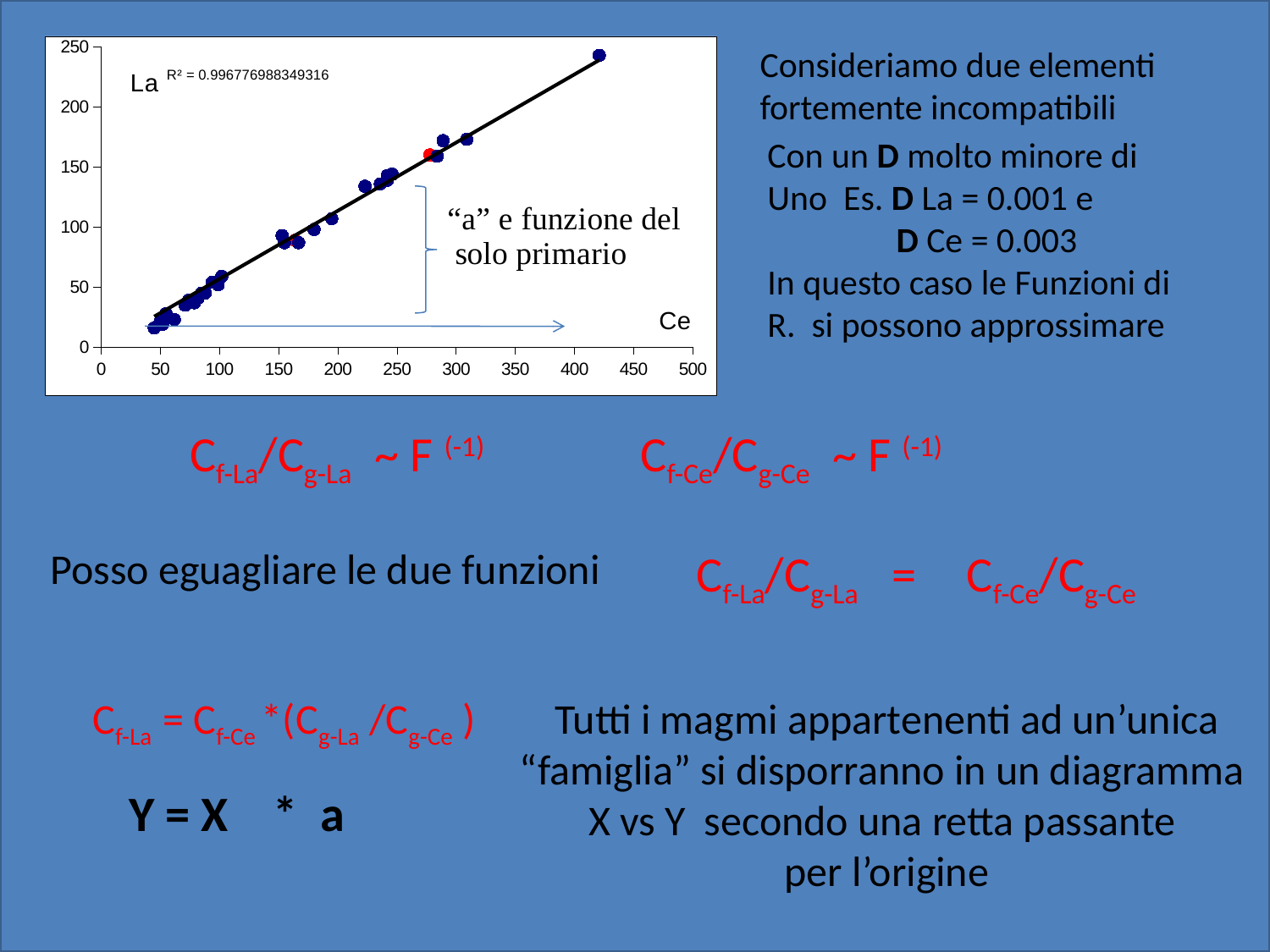
What kind of chart is shown on the slide? scatter chart Is the La value of the lowest point on the chart greater or less than 50? less What label is shown on the vertical axis of the chart? La Is the Ce value of the highest point on the chart greater or less than 400? greater Do the La values rise or fall as Ce increases along the x axis? rise Is the Ce value of the red point on the chart greater or less than 250? greater What is the R² value printed on the chart? R² = 0.996776988349316 What is the maximum value shown on the y axis of the chart? 250 What is the maximum value shown on the x axis of the chart? 500